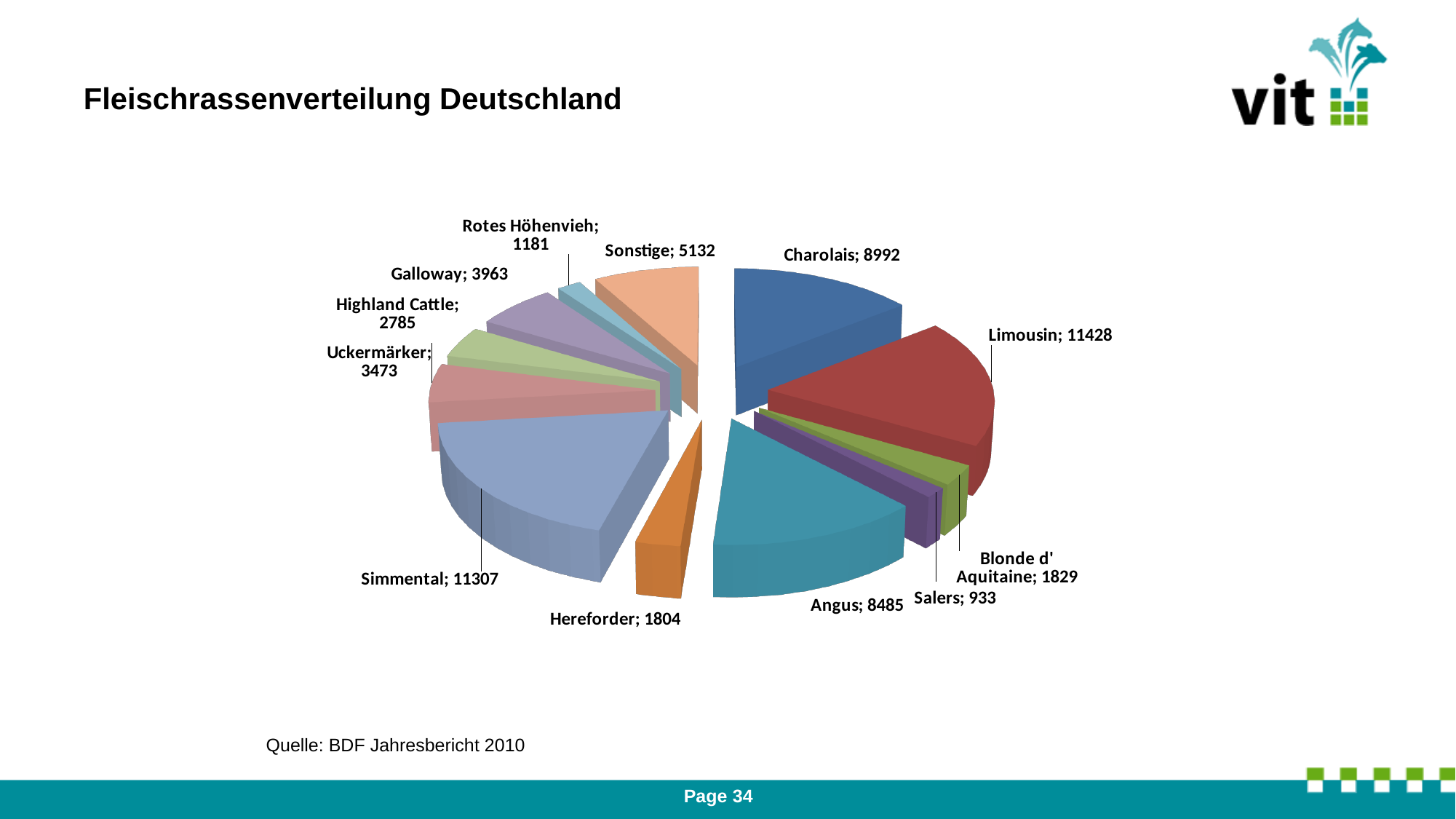
How many categories does the pie chart show? 12 Which category has the highest value? Limousin What is the value for Sonstige? 5132 Which is larger, the value for Galloway or the value for Uckermärker? Galloway What is the difference between the values for Charolais and Angus? 507 What kind of chart is shown on the slide? Pie chart What is the difference between the values for Limousin and Simmental? 121 What is the value for Highland Cattle? 2785 What is the title of the slide containing the chart? Fleischrassenverteilung Deutschland Which category has the lowest value? Salers What is the value for Charolais? 8992 What is the value for Simmental? 11307